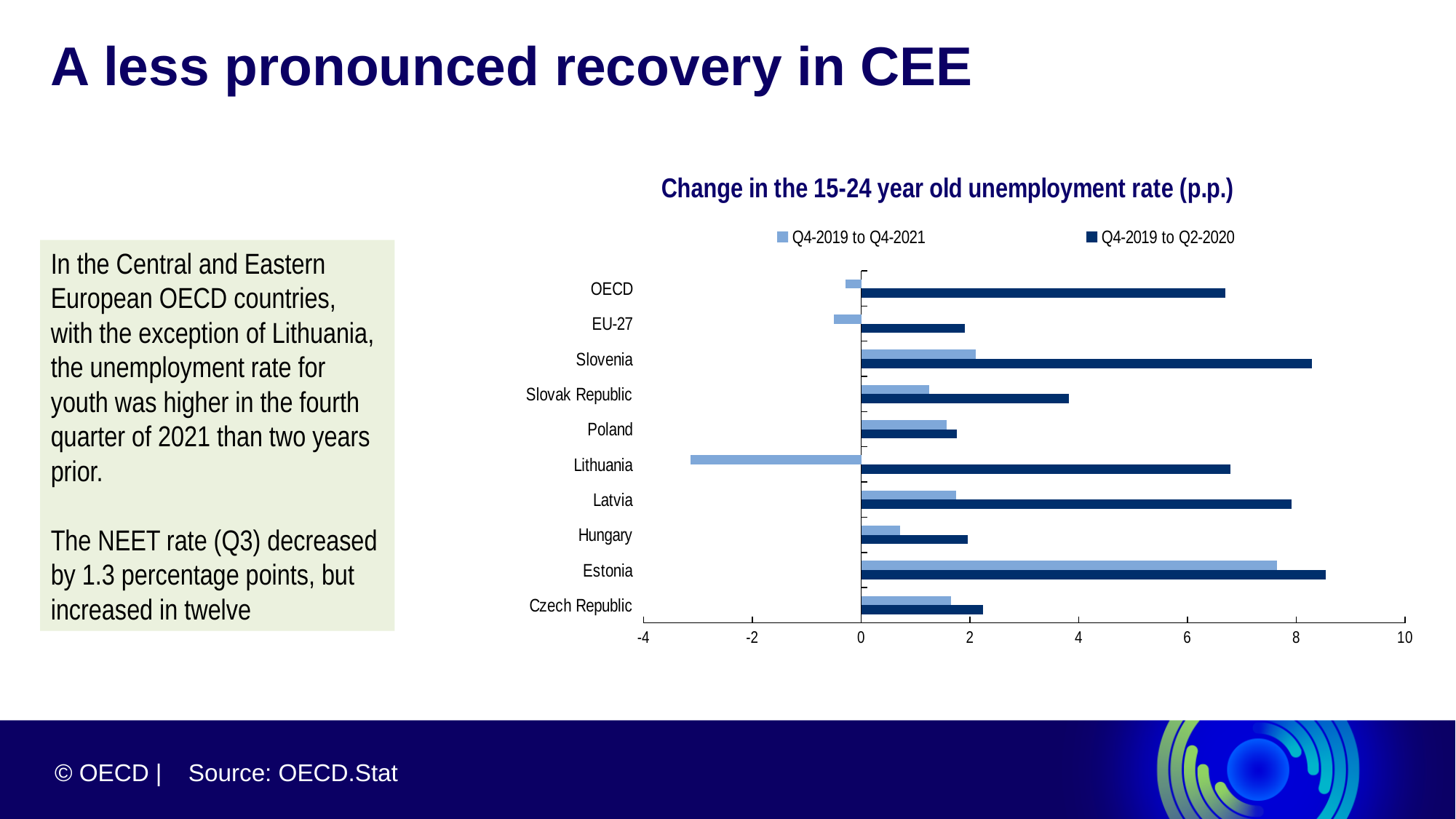
For OECD, which series has the larger value: Q4-2019 to Q4-2021 or Q4-2019 to Q2-2020? Q4-2019 to Q2-2020 Which country has the lowest value for the Q4-2019 to Q4-2021 series? Lithuania What is the title of the chart? Change in the 15-24 year old unemployment rate (p.p.) For the Q4-2019 to Q2-2020 series, which is larger: Slovenia or Slovak Republic? Slovenia Which country has the highest value for the Q4-2019 to Q4-2021 series? Estonia Is the Q4-2019 to Q4-2021 value for Estonia greater or less than 6? greater Is the Q4-2019 to Q2-2020 value for OECD greater or less than 6? greater Is the Q4-2019 to Q4-2021 value for Lithuania greater or less than -2? less What kind of chart is shown on the slide? bar chart Which series is shown in the darker blue colour? Q4-2019 to Q2-2020 How many series does the chart's legend list? 2 How many countries or regions are listed on the chart's vertical axis? 10